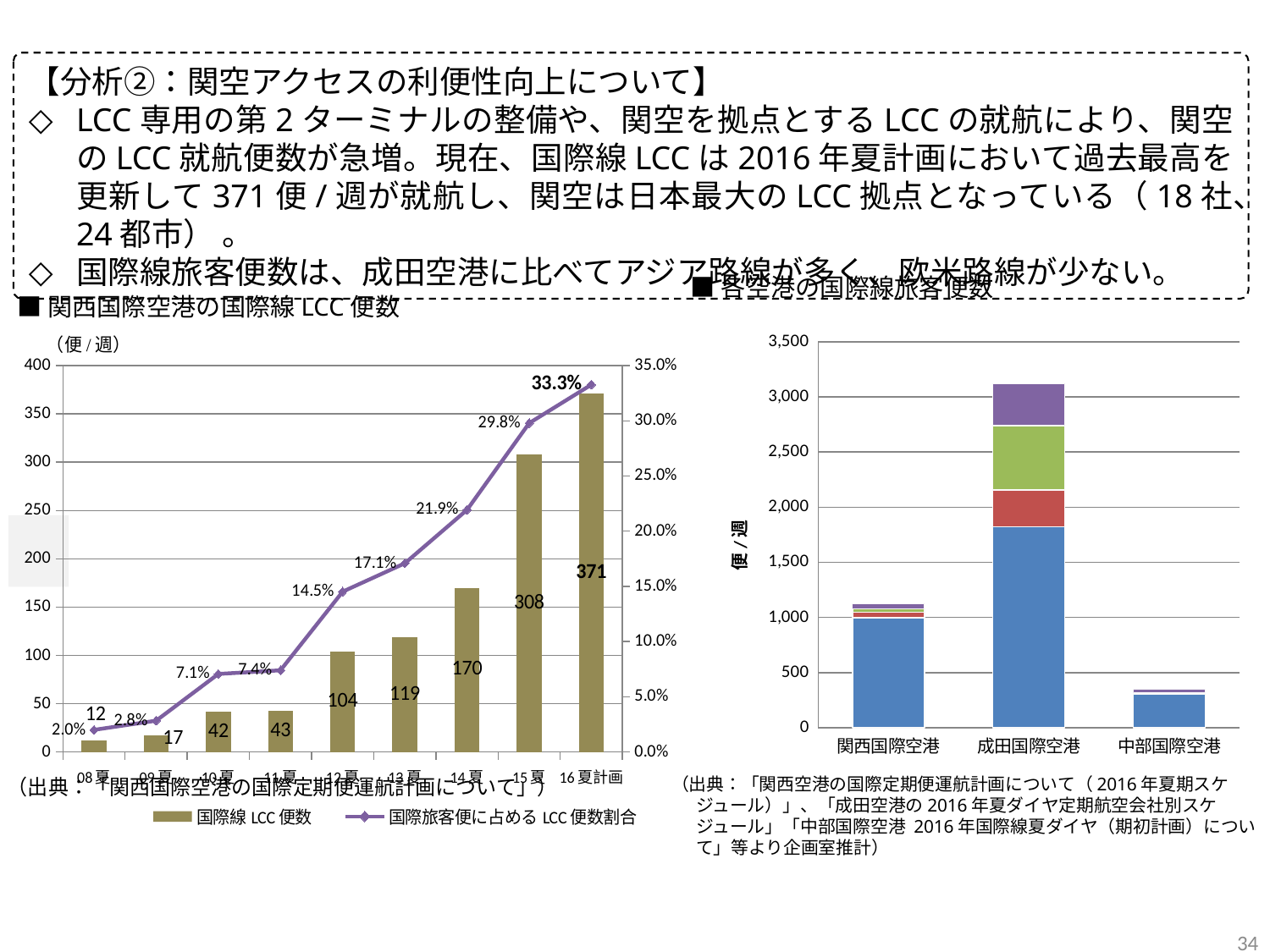
In the left chart (関西国際空港の国際線LCC便数), what is the difference in 国際線LCC便数 between 16夏計画 and 15夏? 63 In the left chart (関西国際空港の国際線LCC便数), what is the 国際旅客便に占めるLCC便数割合 for 16夏計画? 33.3% In the right chart (各空港の国際線旅客便数), is the total for 成田国際空港 greater or less than 3,000? greater In the left chart (関西国際空港の国際線LCC便数), does the 国際旅客便に占めるLCC便数割合 rise or fall from 08夏 to 16夏計画? rise In the right chart (各空港の国際線旅客便数), how many airports are shown on the x axis? 3 In the left chart (関西国際空港の国際線LCC便数), which is larger, the 国際線LCC便数 for 13夏 or for 12夏? 13夏 In the left chart (関西国際空港の国際線LCC便数), what is the value of 国際線LCC便数 for 15夏? 308 In the left chart (関西国際空港の国際線LCC便数), what is the value of 国際線LCC便数 for 16夏計画? 371 In the left chart (関西国際空港の国際線LCC便数), how many series does the legend list? 2 In the left chart (関西国際空港の国際線LCC便数), which period has the lowest 国際線LCC便数? 08夏 In the right chart (各空港の国際線旅客便数), which airport has the lowest total 国際線旅客便数? 中部国際空港 In the left chart (関西国際空港の国際線LCC便数), what is the 国際旅客便に占めるLCC便数割合 for 12夏? 14.5%